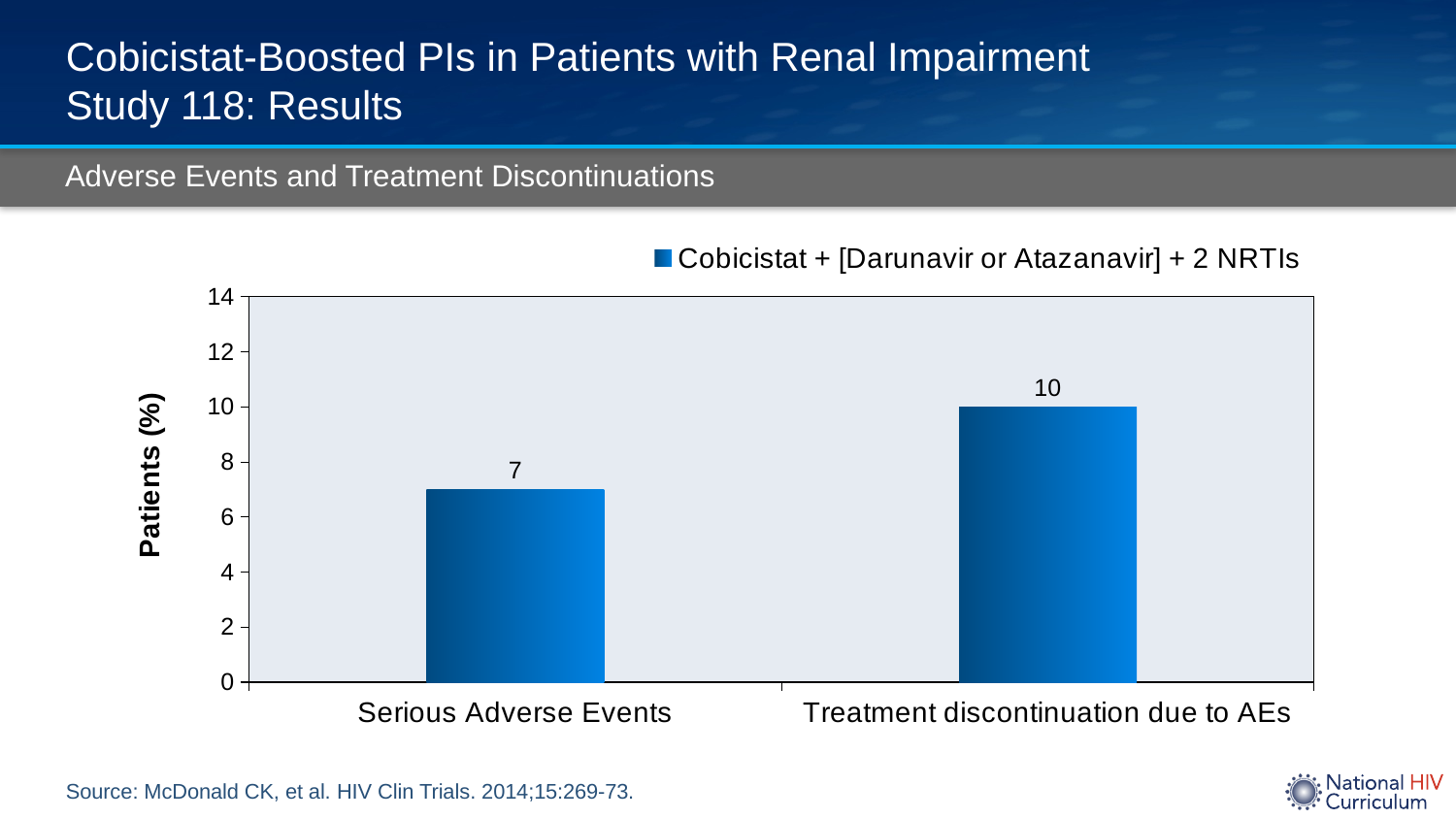
What kind of chart is shown on the slide? Bar chart What is the label of the y axis? Patients (%) What is the difference between the values for Treatment discontinuation due to AEs and Serious Adverse Events? 3 What is the value for Treatment discontinuation due to AEs? 10 How many series does the legend list? 1 Is the value for Serious Adverse Events greater or less than 8? less How many categories are shown on the x axis? 2 Which is larger: the value for Serious Adverse Events or the value for Treatment discontinuation due to AEs? Treatment discontinuation due to AEs Which category has the highest value? Treatment discontinuation due to AEs What series name is shown in the legend? Cobicistat + [Darunavir or Atazanavir] + 2 NRTIs Which category has the lowest value? Serious Adverse Events What is the value for Serious Adverse Events? 7